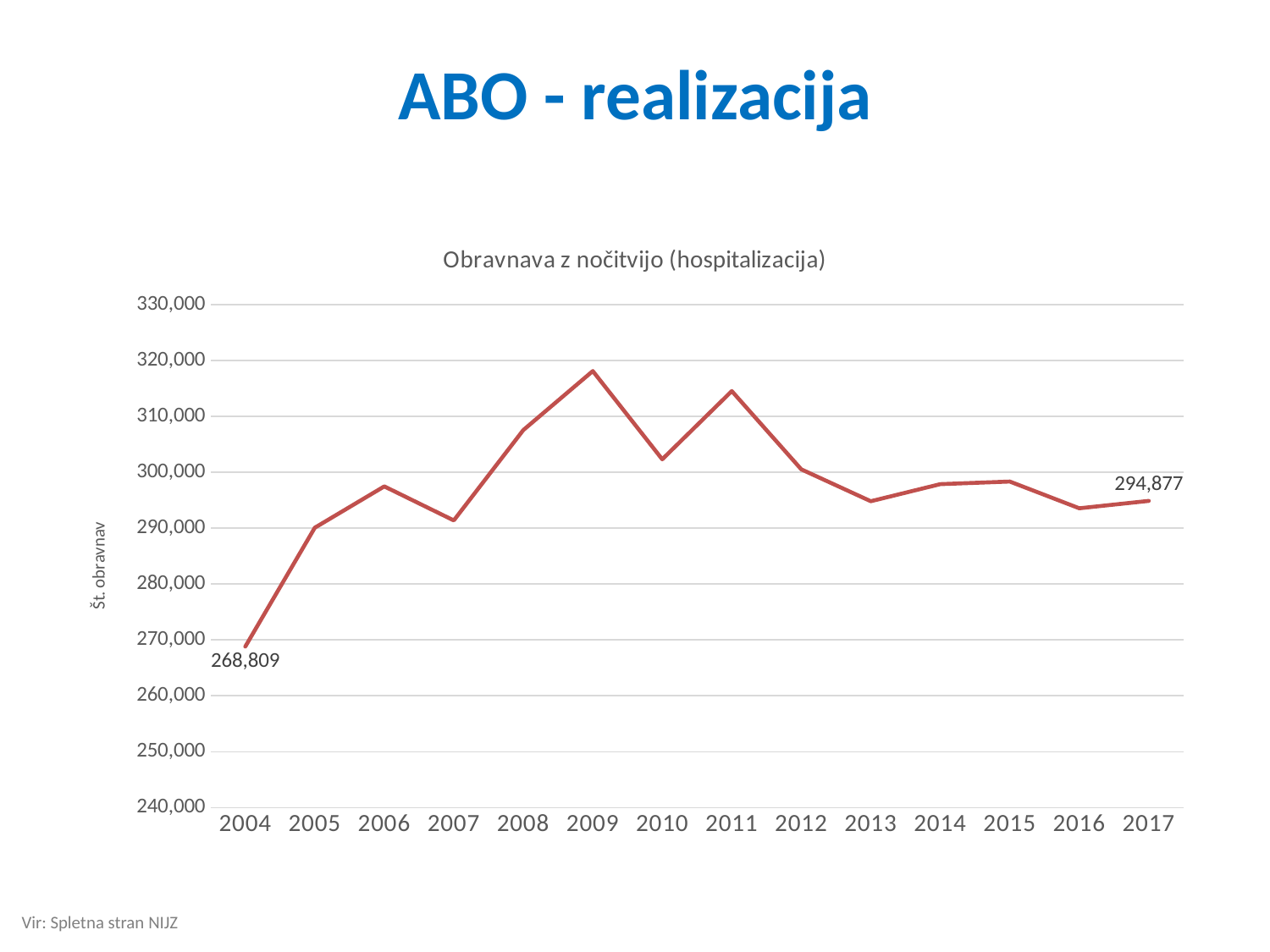
What is the title of the chart? Obravnava z nočitvijo (hospitalizacija) What is the value for 2004 in the chart? 268,809 Is the value for 2009 greater or less than 310,000? greater Is the value for 2013 greater or less than 300,000? less What is the difference between the 2017 value and the 2004 value? 26,068 What is the value for 2017 in the chart? 294,877 How many years are plotted on the x axis? 14 Which year has the lowest value in the chart? 2004 Do the values rise or fall from 2004 to 2009? rise Which is larger, the value for 2009 or the value for 2011? 2009 Which year has the highest value in the chart? 2009 What kind of chart is shown on the slide? line chart